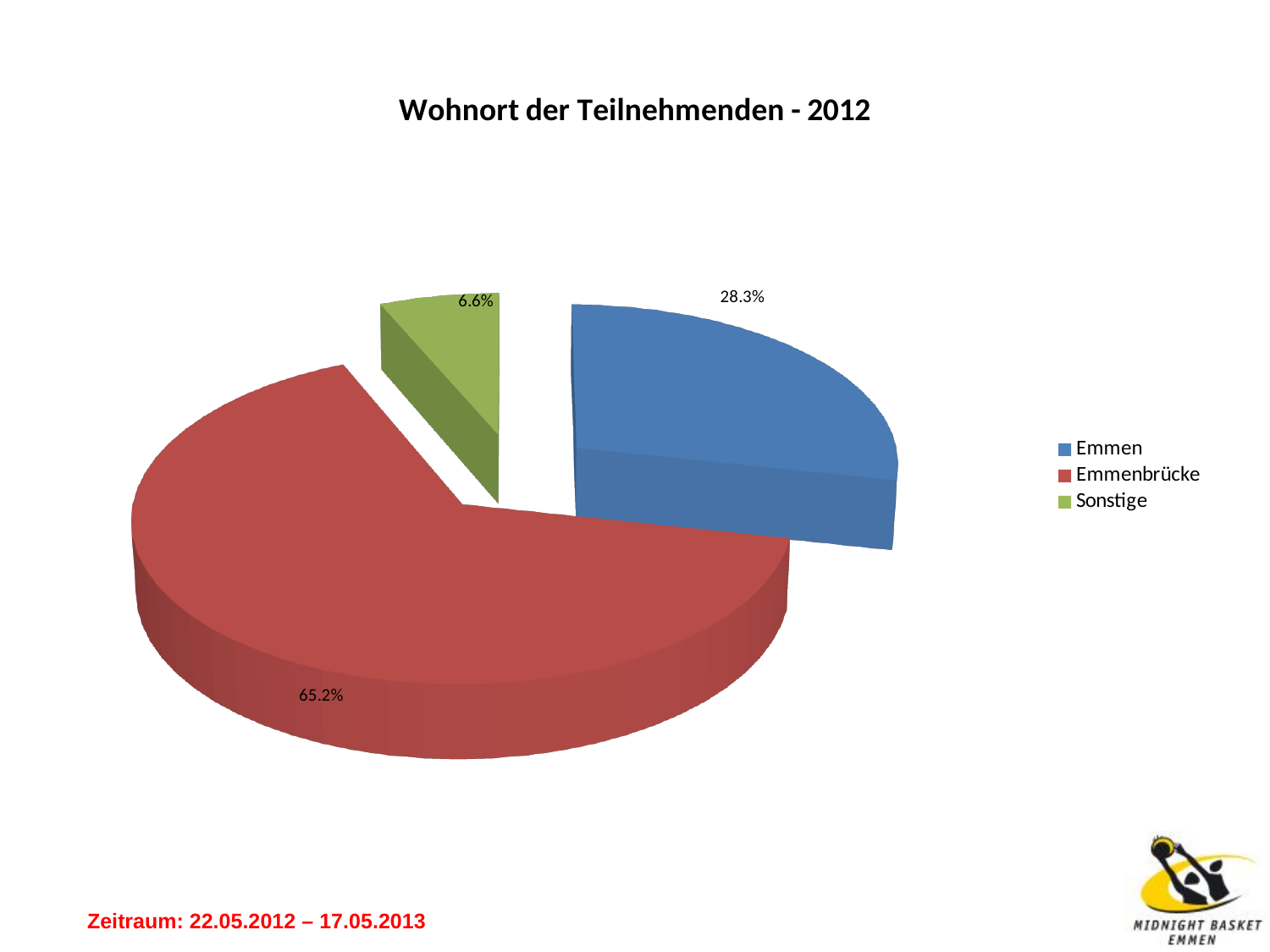
How many categories are shown in the pie chart? 3 Which colour represents Sonstige in the chart? Green Which category has the smallest slice? Sonstige What type of chart is shown on the slide? Pie chart What share of the pie does Emmen have? 28.3% Which is larger, the share for Emmen or the share for Sonstige? Emmen What share of the pie does Emmenbrücke have? 65.2% How many entries does the legend list? 3 Which category has the largest slice? Emmenbrücke What is the difference in percentage points between Emmenbrücke and Emmen? 36.9 What is the title of the chart? Wohnort der Teilnehmenden - 2012 What share of the pie does Sonstige have? 6.6%